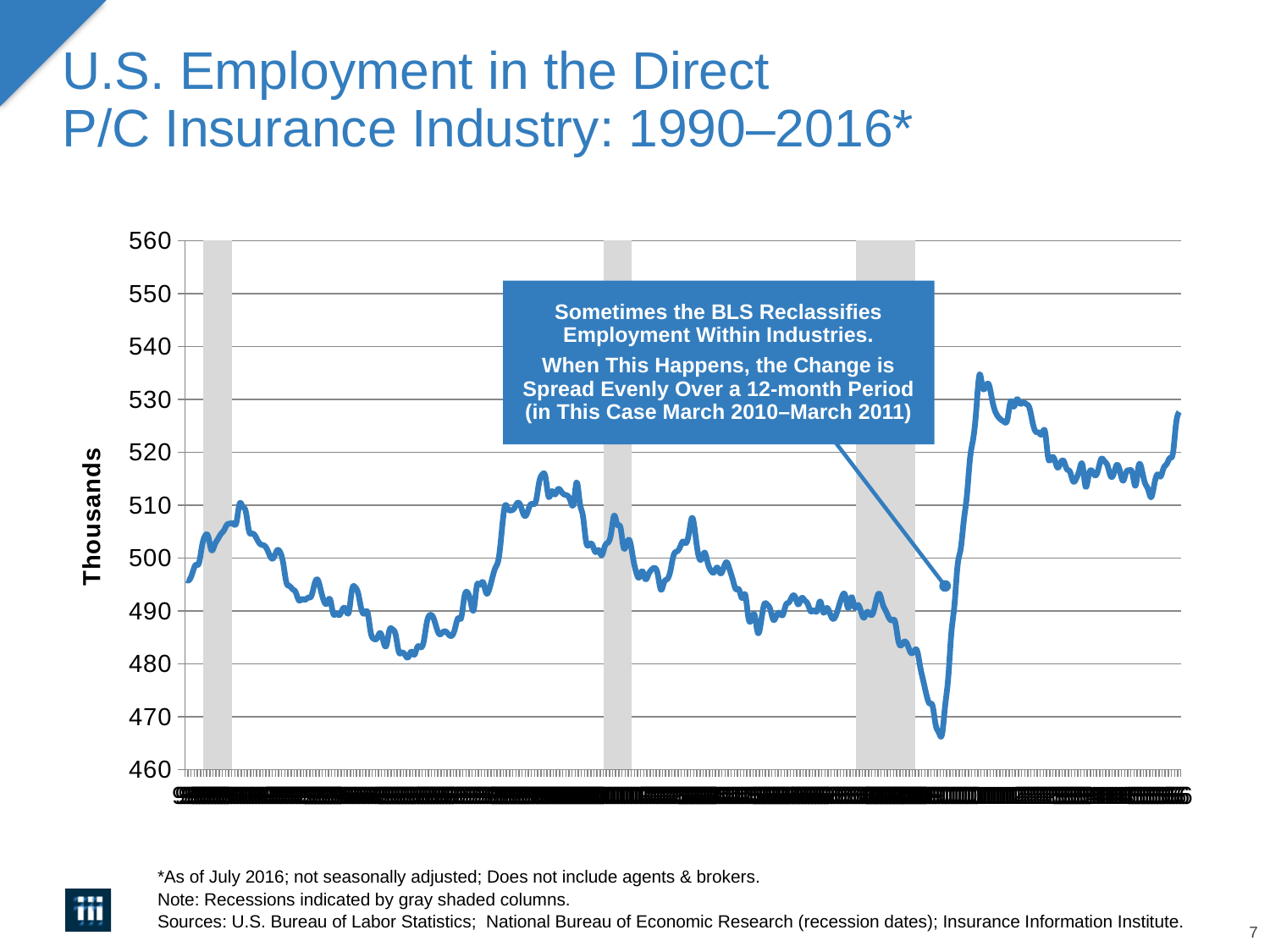
Is the value at the far left start of the line greater or less than 500? less Is the lowest point of the line greater or less than 480? less What is the label on the vertical axis of the chart? Thousands Is the lowest point of the employment line greater or less than 470? less How many gray shaded recession columns appear on the chart? 3 Does the line rise or fall immediately after its lowest point near the third gray shaded column? rise What kind of chart is shown on the slide? line chart What is the highest value shown on the vertical axis? 560